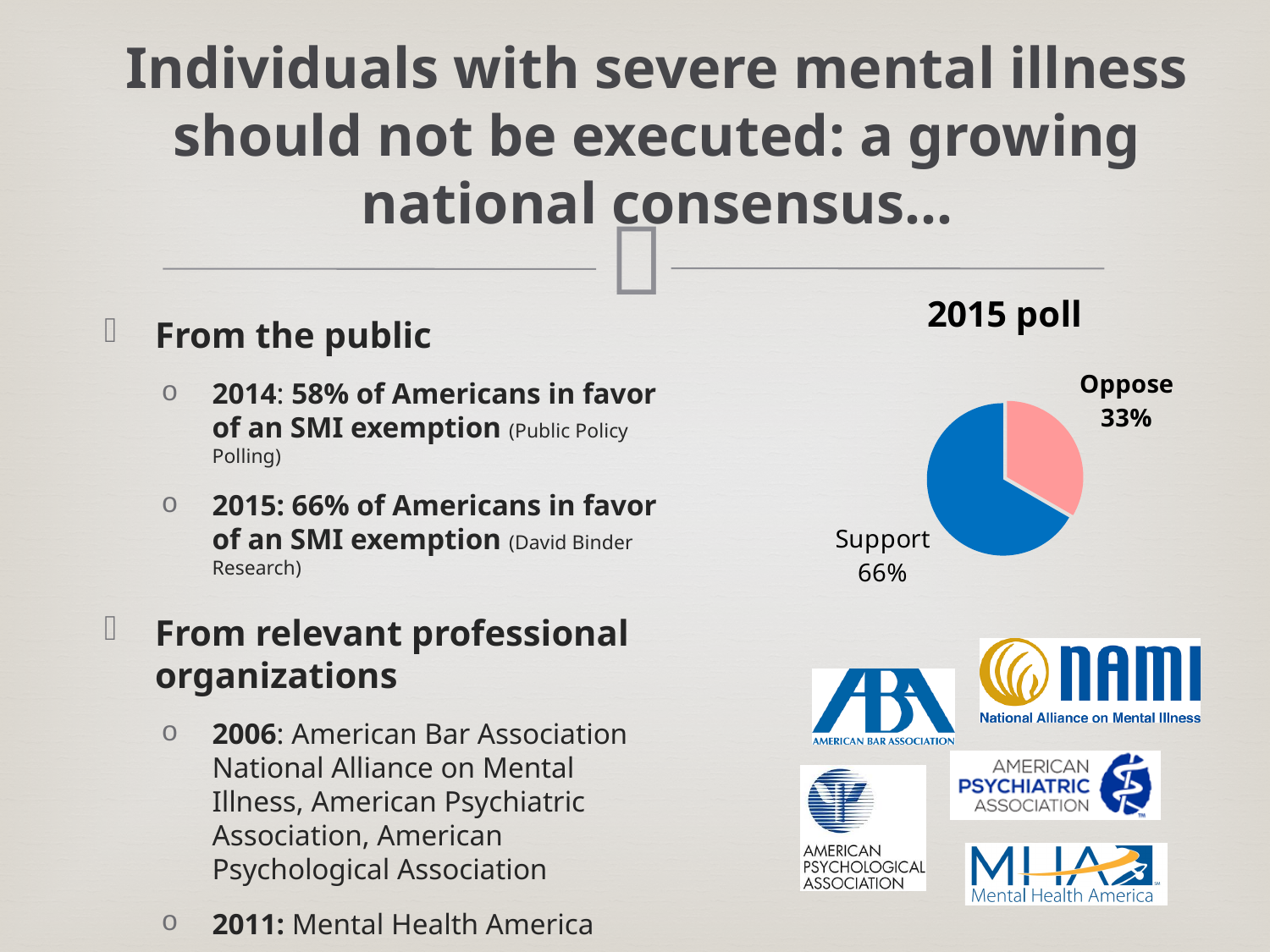
What colour is the Support slice in the 2015 poll pie chart? blue What is the value for Support in the 2015 poll pie chart? 66% How many slices does the 2015 poll pie chart have? 2 What is the title of the pie chart on the slide? 2015 poll What is the difference between the Support and Oppose values in the 2015 poll pie chart? 33% What is the value for Oppose in the 2015 poll pie chart? 33% What type of chart is shown under the title "2015 poll"? pie chart Which slice of the 2015 poll pie chart is the largest? Support Which slice of the 2015 poll pie chart is the smallest? Oppose In the 2015 poll pie chart, is the Support value larger or smaller than the Oppose value? larger